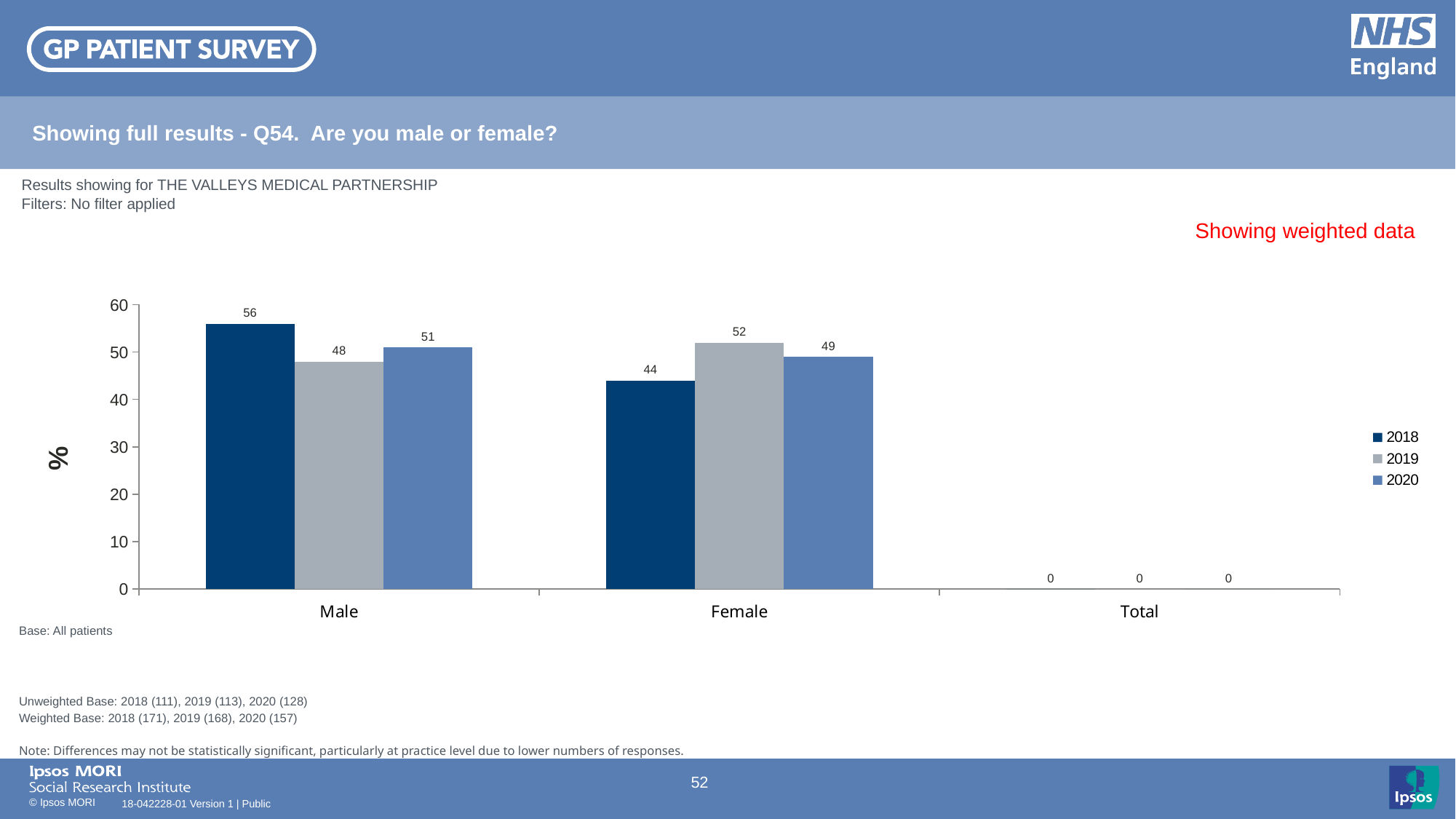
How many series does the legend list? 3 What is the difference between the Male and Female values in 2018? 12 Which is larger, the Male value in 2019 or the Female value in 2019? Female What is the value for Male in 2018? 56 What is the value for Female in 2018? 44 How many categories are shown on the x axis? 3 Which year has the lowest value for Female? 2018 What is the label on the vertical axis? % Which year has the highest value for Male? 2018 What is the value for Female in 2019? 52 What is the value for Male in 2020? 51 What kind of chart is shown on the slide? Bar chart